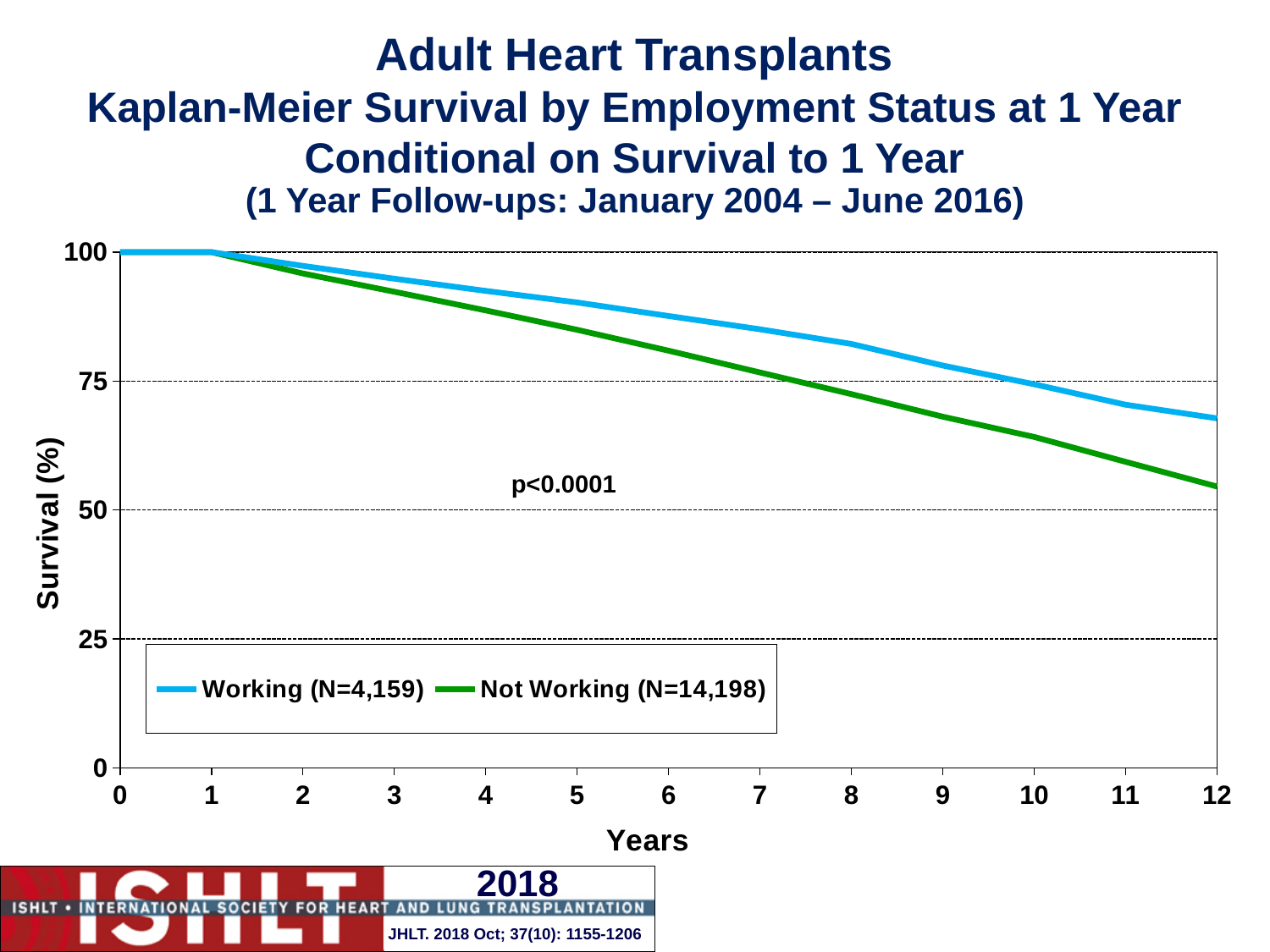
Is the survival value for the Not Working group at 8 years greater or less than 75? less How many series does the legend list? 2 What is the sample size (N) for the Working group shown in the legend? 4,159 Is the survival value for the Working group at 12 years greater or less than 50? greater Is the survival value for the Not Working group at 12 years greater or less than 75? less Do the survival values rise or fall as the years increase? Fall What p-value is printed on the chart? p<0.0001 What is the survival value for both groups at 1 year? 100 At 12 years, which group has higher survival: Working or Not Working? Working What kind of chart is shown on the slide? Line chart